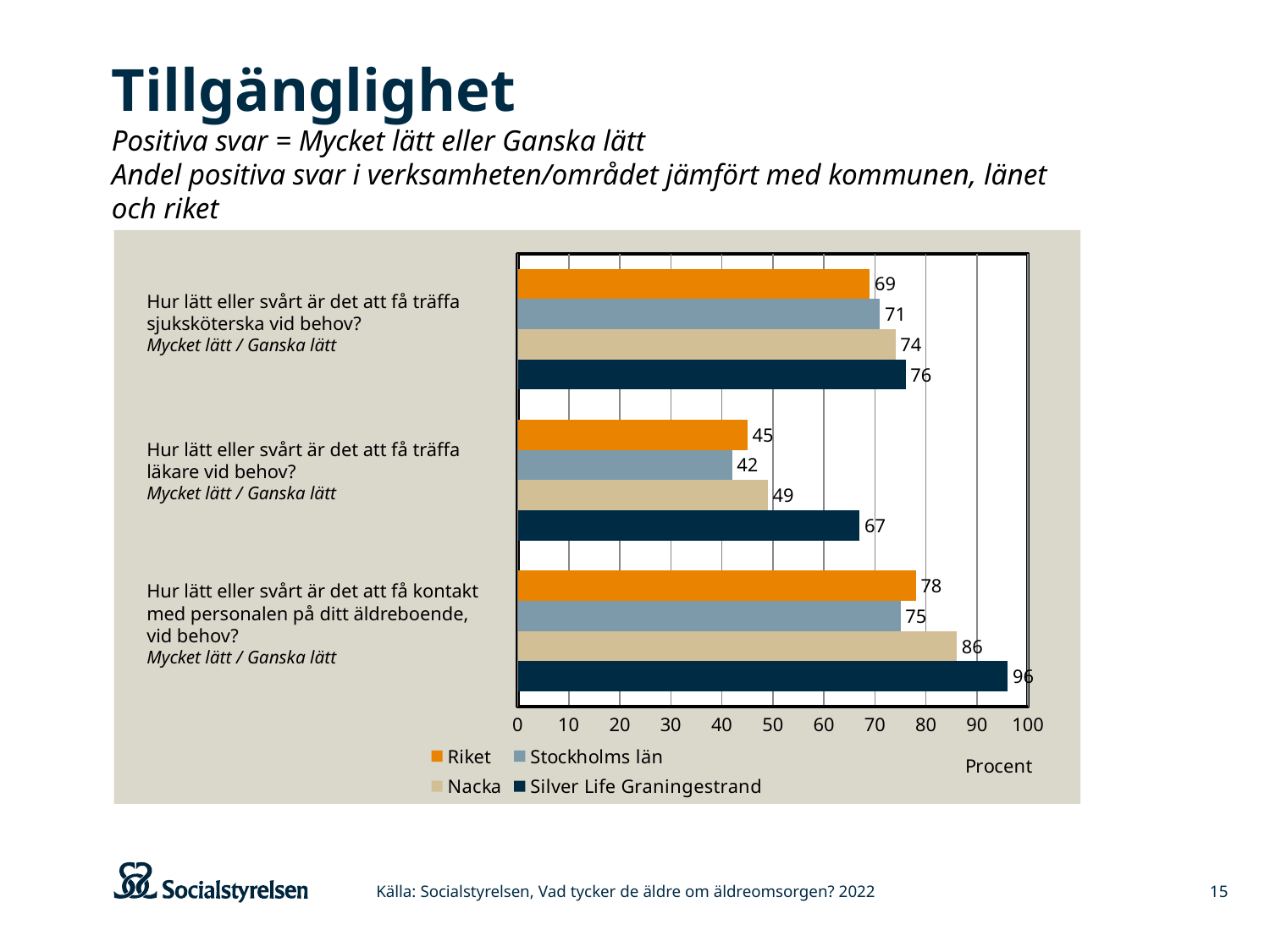
What is the value for Stockholms län on the question about meeting a doctor when needed ("få träffa läkare vid behov")? 42 How many series does the legend list? 4 Which series has the lowest value on the question about meeting a nurse when needed? Riket What is the value for Riket on the question about meeting a doctor when needed? 45 What is the difference between Silver Life Graningestrand and Riket on the question about meeting a doctor when needed? 22 What is the label of the x axis? Procent What is the value for Nacka on the question about meeting a nurse when needed ("få träffa sjuksköterska vid behov")? 74 What is the difference between Silver Life Graningestrand and Nacka on the question about getting in contact with staff at the care home? 10 What kind of chart is shown on the slide? Bar chart Which series has the highest value on the question about meeting a doctor when needed? Silver Life Graningestrand What is the value for Silver Life Graningestrand on the question about getting in contact with staff at the care home ("få kontakt med personalen på ditt äldreboende")? 96 Which is larger on the question about getting in contact with staff at the care home: Riket or Stockholms län? Riket